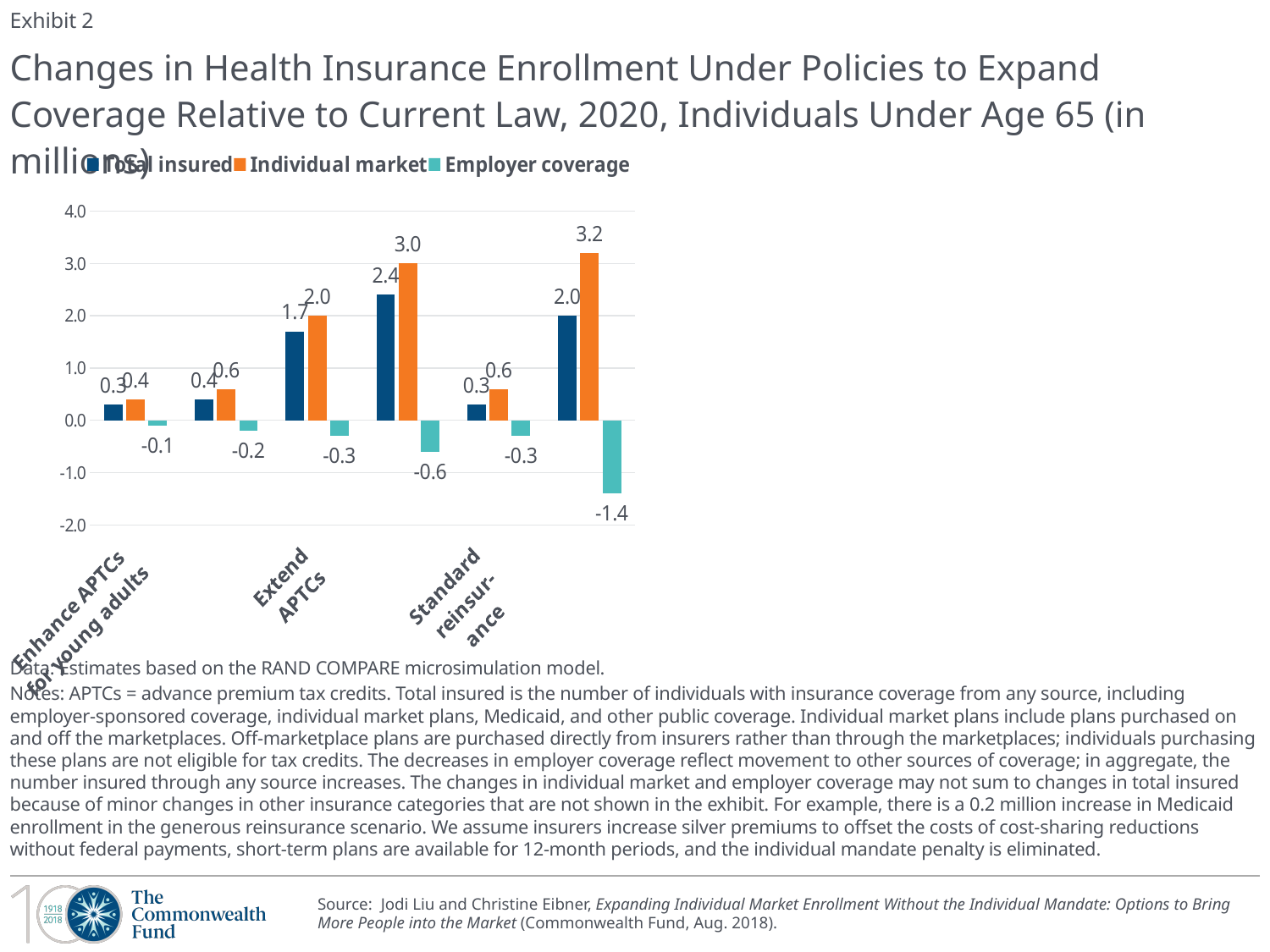
Which has the larger Individual market value, Extend APTCs or Standard reinsurance? Extend APTCs How many groups of bars are plotted in the chart? 6 What is the highest value shown for the Individual market series? 3.2 What is the lowest value shown for the Employer coverage series? -1.4 What is the Employer coverage value for Enhance APTCs for young adults? -0.1 How many series does the legend list? 3 Which series is shown in teal in the legend? Employer coverage What is the Individual market value for Extend APTCs? 2.0 What kind of chart is shown on the slide? bar chart What is the difference between the Individual market and Total insured values for Extend APTCs? 0.3 What is the Total insured value for Extend APTCs? 1.7 What is the highest value shown for the Total insured series? 2.4